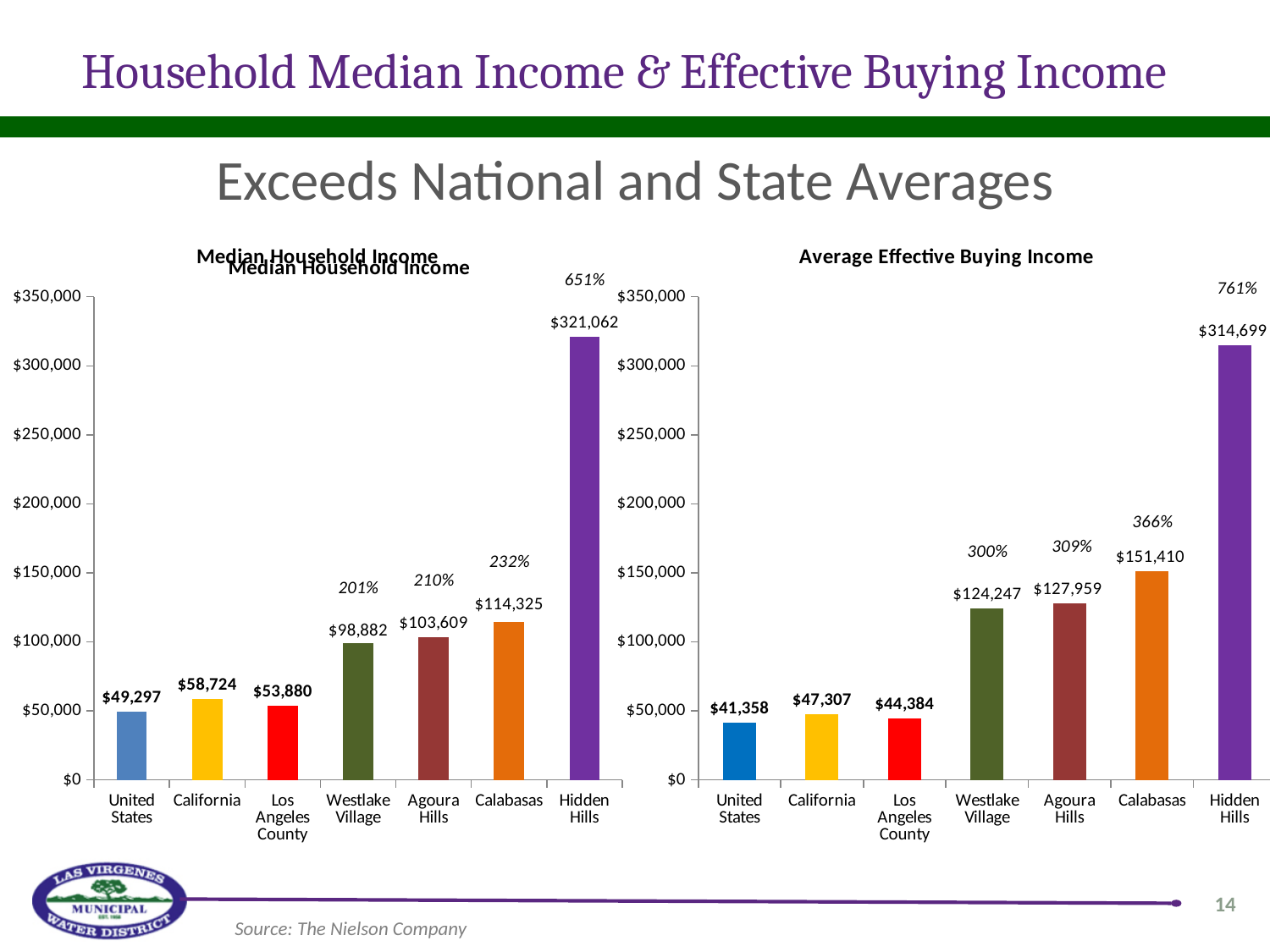
In the Median Household Income chart, what is the value for Hidden Hills? $321,062 In the Median Household Income chart, what is the difference between Agoura Hills and Westlake Village? $4,727 In the Average Effective Buying Income chart, which is larger, California or Los Angeles County? California In the Median Household Income chart, is the value for Calabasas greater or less than $100,000? greater In the Average Effective Buying Income chart, what is the value for Calabasas? $151,410 How many categories are shown in the Average Effective Buying Income chart? 7 In the Average Effective Buying Income chart, what is the value for United States? $41,358 In the Median Household Income chart, which category has the highest value? Hidden Hills In the Average Effective Buying Income chart, what percentage label is shown above the Hidden Hills bar? 761% In the Average Effective Buying Income chart, which category has the lowest value? United States What kind of chart is the Median Household Income chart? bar chart In the Median Household Income chart, what is the value for California? $58,724